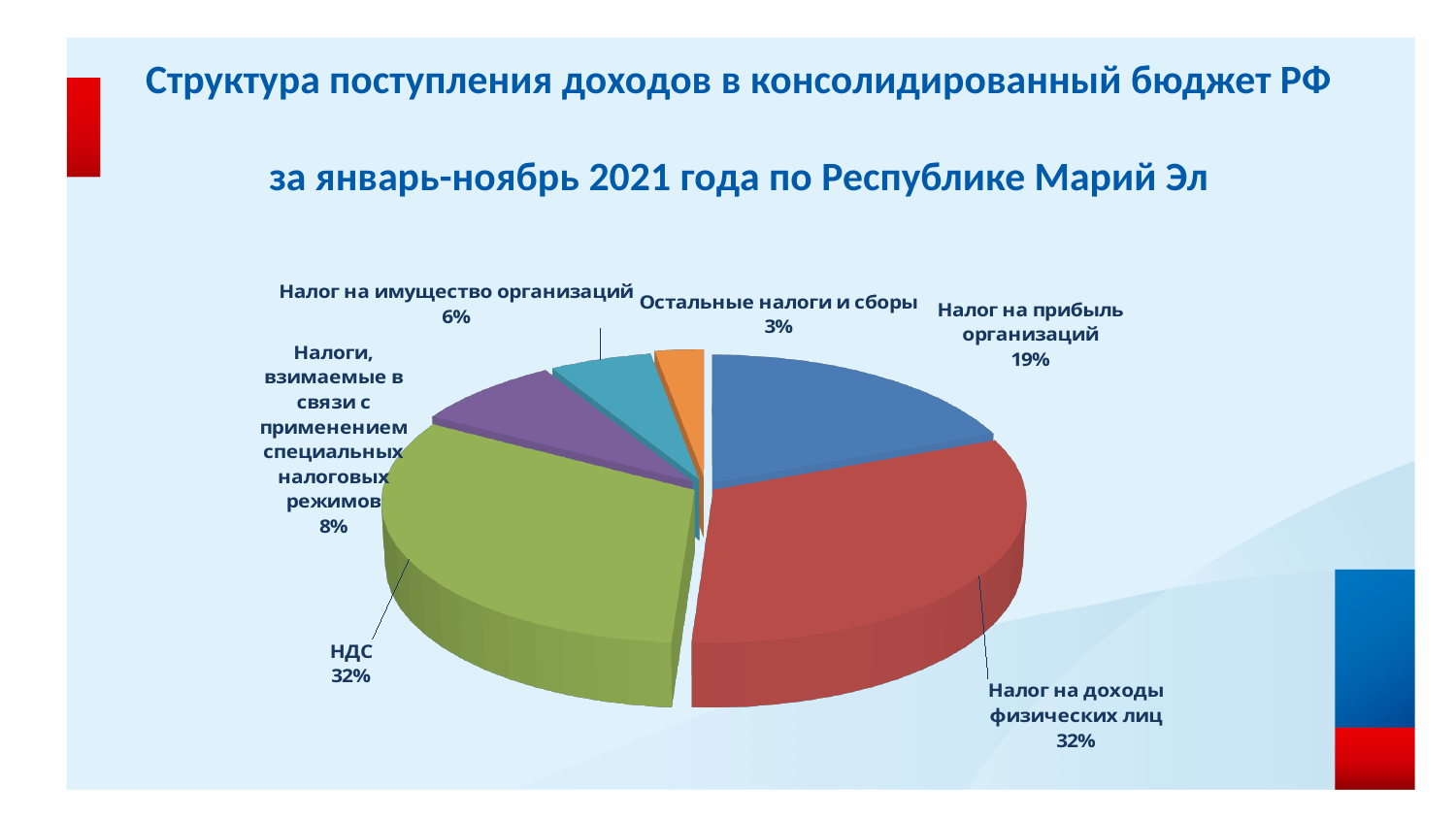
What share of the pie is labelled "Налоги, взимаемые в связи с применением специальных налоговых режимов"? 8% Which is larger: the share for "Налог на имущество организаций" or the share for "Налоги, взимаемые в связи с применением специальных налоговых режимов"? Налоги, взимаемые в связи с применением специальных налоговых режимов What share of the pie is labelled "Остальные налоги и сборы"? 3% What is the difference in percentage points between "Налог на доходы физических лиц" and "Налог на прибыль организаций"? 13 How many slices does the pie chart have? 6 What share of the pie is labelled "Налог на имущество организаций"? 6% Which category has the smallest share of the pie? Остальные налоги и сборы What kind of chart is shown on the slide? Pie chart What period does the chart title say the data covers? январь-ноябрь 2021 года